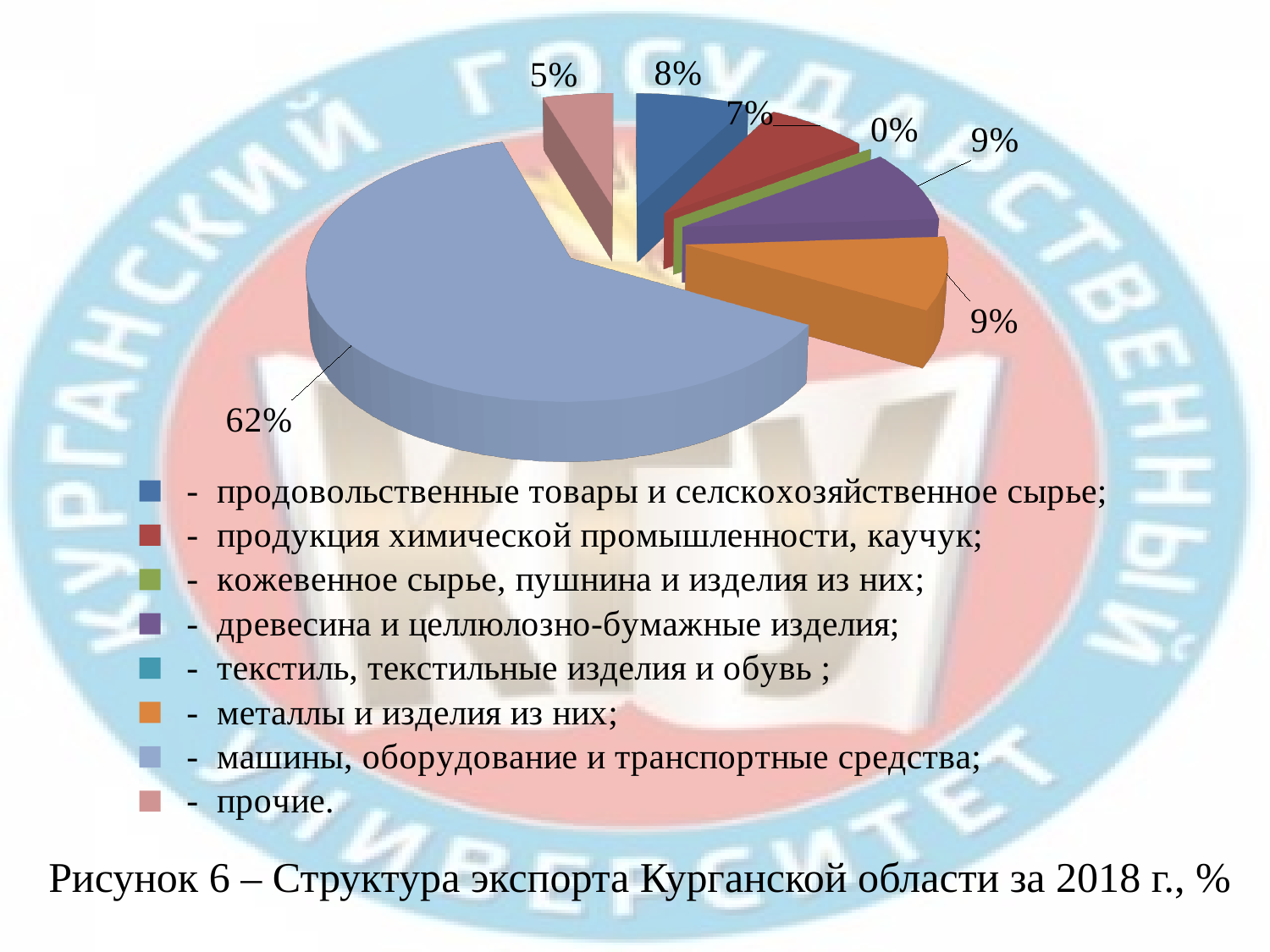
How many categories does the legend list? 8 Which has the larger share: "продовольственные товары и селскохозяйственное сырье" or "продукция химической промышленности, каучук"? продовольственные товары и селскохозяйственное сырье What share is shown for "продовольственные товары и селскохозяйственное сырье"? 8% What share is shown for "древесина и целлюлозно-бумажные изделия"? 9% What share of exports is shown for "машины, оборудование и транспортные средства"? 62% What is the caption of the figure on the slide? Рисунок 6 – Структура экспорта Курганской области за 2018 г., % Which category has the largest share of the pie? машины, оборудование и транспортные средства What kind of chart is shown on the slide? pie chart What share is shown for "продукция химической промышленности, каучук"? 7% What share is shown for "прочие"? 5% What share is shown for "металлы и изделия из них"? 9% By how many percentage points does the share of "машины, оборудование и транспортные средства" exceed that of "продовольственные товары и селскохозяйственное сырье"? 54 percentage points